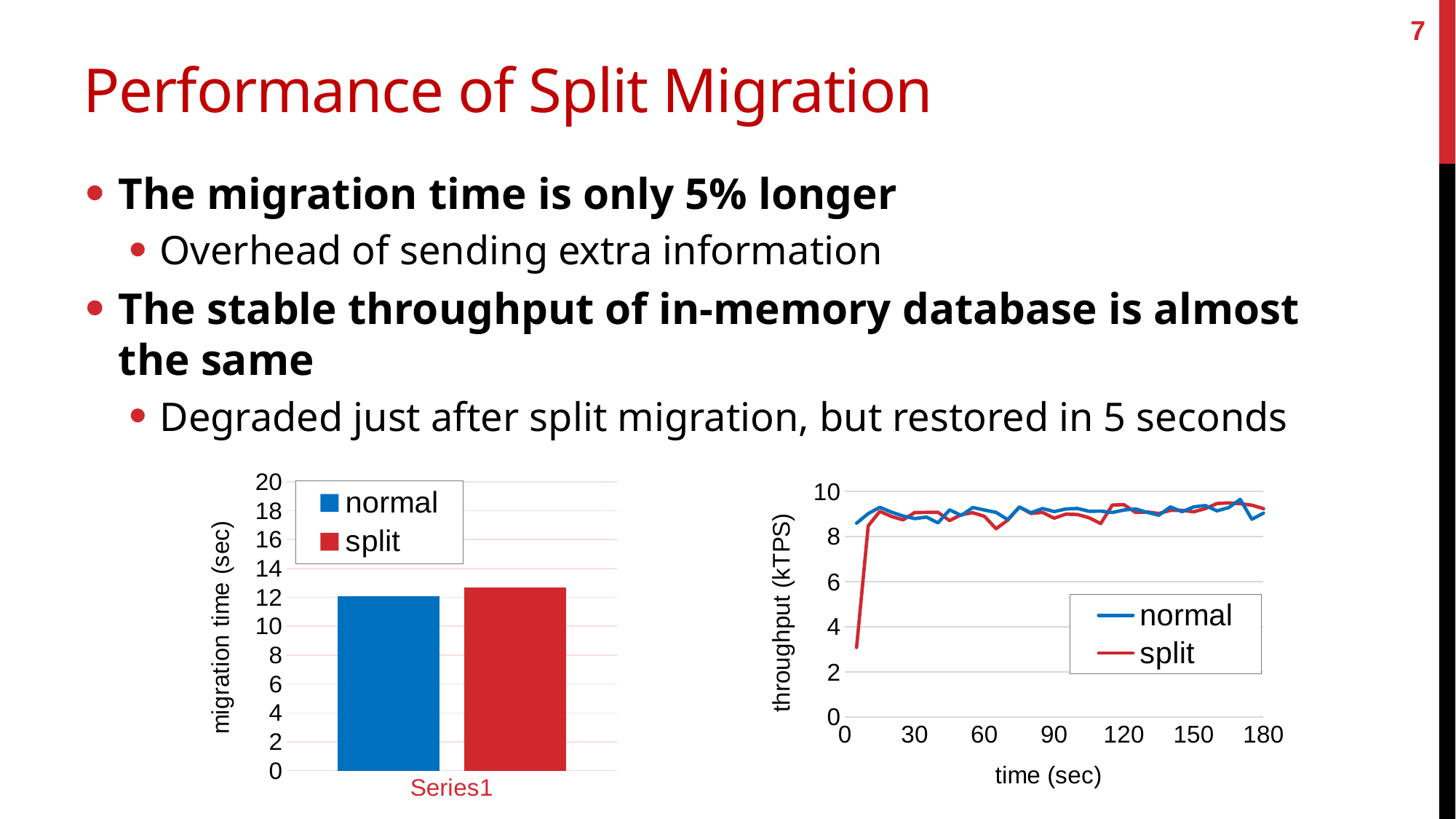
In the right throughput chart, what is the highest value shown on the y axis? 10 In the left migration time chart, what is the y-axis label? migration time (sec) What kind of chart is the left chart showing migration time? bar chart In the right throughput chart, how many series does the legend list? 2 What kind of chart is the right chart showing throughput? line chart In the right throughput chart, is the first plotted value of the split series greater or less than 4? less In the right throughput chart, is the value of the normal series at time 90 greater or less than 8? greater In the left migration time chart, how many series does the legend list? 2 In the right throughput chart, what is the x-axis label? time (sec) In the left migration time chart, which series has the higher migration time, normal or split? split In the left migration time chart, is the value for normal greater or less than 10? greater